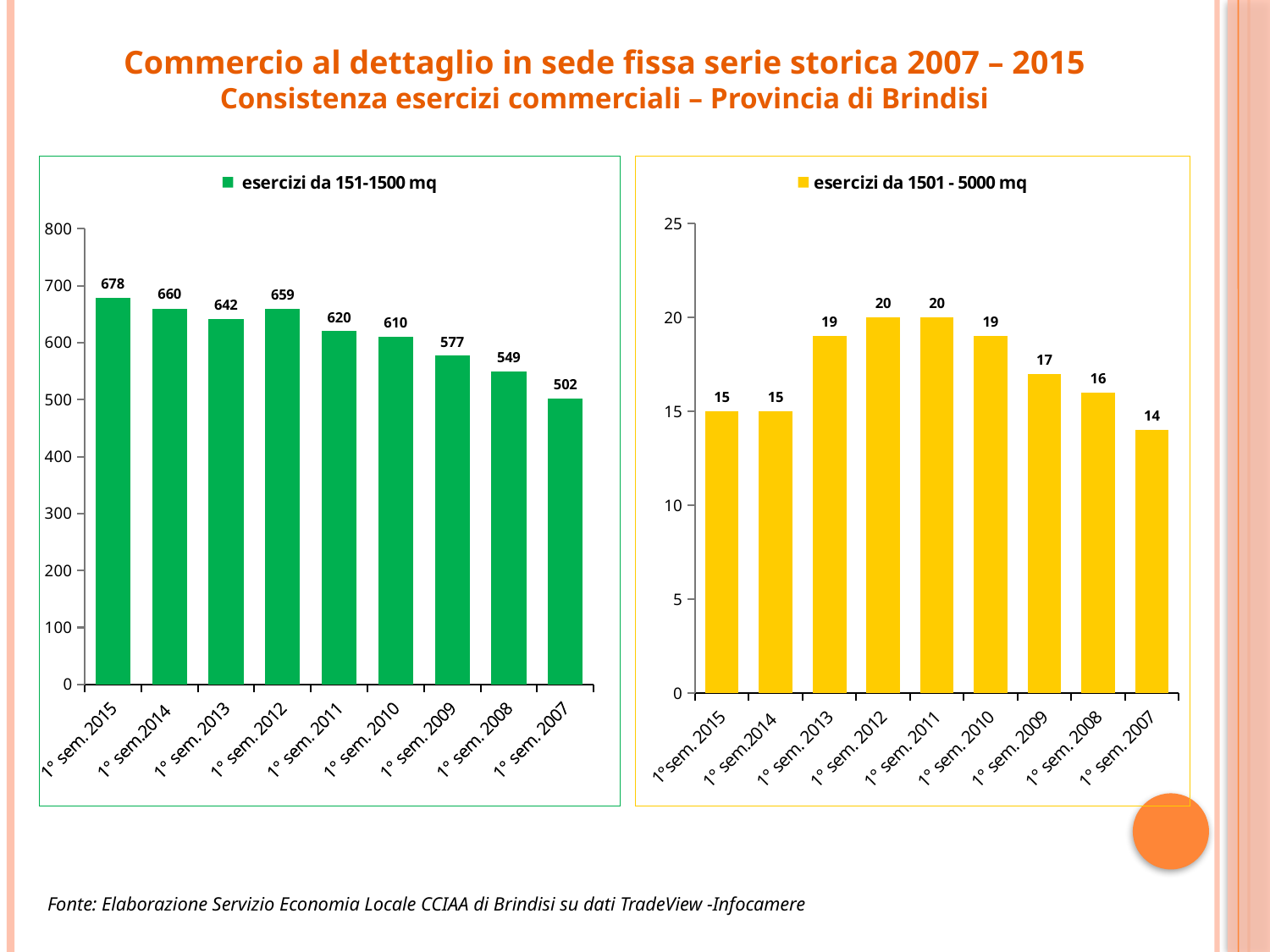
In the left chart (esercizi da 151-1500 mq), what is the value for 1° sem. 2009? 577 How many series does the legend of the left chart list? 1 In the left chart (esercizi da 151-1500 mq), is the value for 1° sem. 2010 greater or less than 600? greater In the right chart (esercizi da 1501 - 5000 mq), what is the value for 1° sem. 2008? 16 In the right chart (esercizi da 1501 - 5000 mq), which category has the lowest value? 1° sem. 2007 What kind of chart is the right chart (esercizi da 1501 - 5000 mq)? bar chart In the right chart (esercizi da 1501 - 5000 mq), what is the difference between the values for 1° sem. 2012 and 1° sem. 2015? 5 In the left chart (esercizi da 151-1500 mq), which category has the lowest value? 1° sem. 2007 In the right chart (esercizi da 1501 - 5000 mq), which is larger, the value for 1° sem. 2013 or the value for 1° sem. 2009? 1° sem. 2013 In the left chart (esercizi da 151-1500 mq), what is the value for 1° sem. 2015? 678 In the left chart (esercizi da 151-1500 mq), how many bars are plotted? 9 In the left chart (esercizi da 151-1500 mq), what is the difference between the values for 1° sem. 2015 and 1° sem. 2007? 176